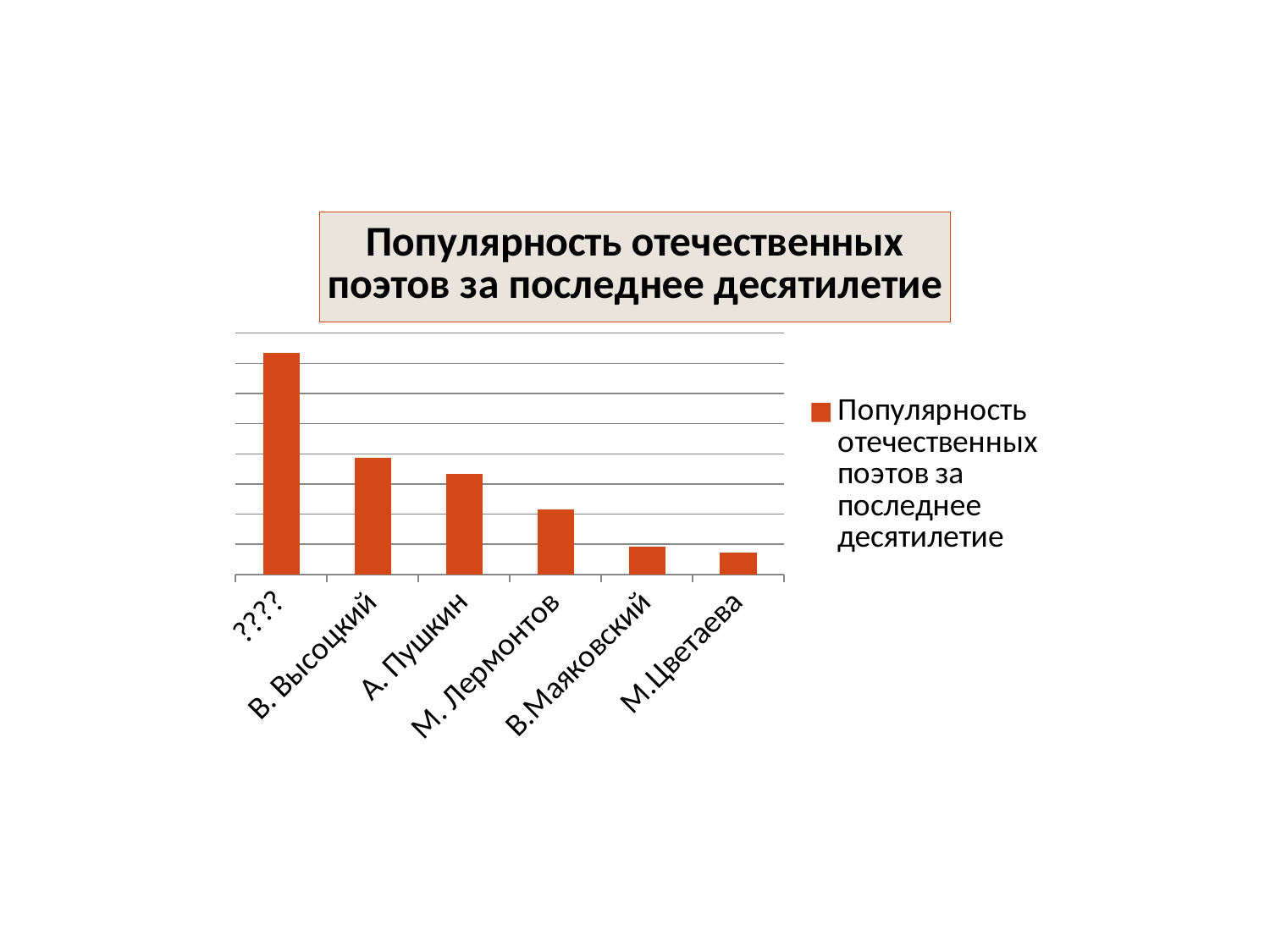
Which bar is taller, В. Высоцкий or А. Пушкин? В. Высоцкий What is the legend entry shown next to the chart? Популярность отечественных поэтов за последнее десятилетие Which category is the last one on the x axis? М.Цветаева Which category has the tallest bar in the chart? ???? How many series does the legend list? 1 Which bar is taller, М. Лермонтов or А. Пушкин? А. Пушкин How many categories (bars) are shown in the chart? 6 Which bar is taller, М. Лермонтов or В.Маяковский? М. Лермонтов What is the title of the chart? Популярность отечественных поэтов за последнее десятилетие Among the named poets, which one has the highest bar? В. Высоцкий Do the bar values rise or fall from left to right along the x axis? fall What kind of chart is shown on the slide? bar chart